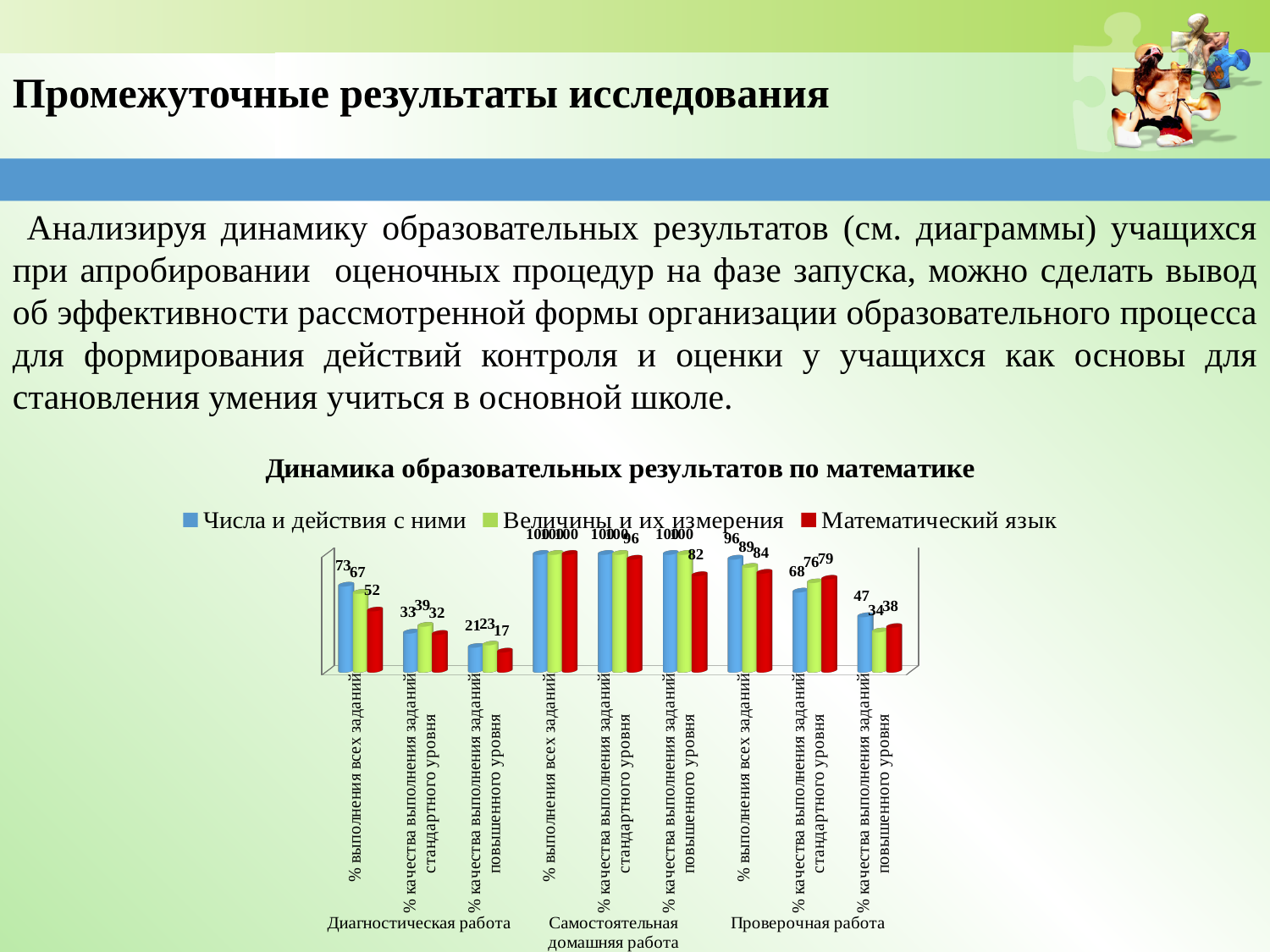
Which series has the lowest value for '% качества выполнения заданий повышенного уровня' in the 'Диагностическая работа' group? Математический язык What is the value of 'Числа и действия с ними' for '% выполнения всех заданий' in the 'Диагностическая работа' group? 73 What is the value of 'Величины и их измерения' for '% качества выполнения заданий стандартного уровня' in the 'Диагностическая работа' group? 39 What is the value of 'Математический язык' for '% выполнения всех заданий' in the 'Диагностическая работа' group? 52 What is the difference between 'Числа и действия с ними' (73) and 'Математический язык' (52) for '% выполнения всех заданий' in the 'Диагностическая работа' group? 21 What is the value of 'Числа и действия с ними' for '% выполнения всех заданий' in the 'Проверочная работа' group? 96 How many series does the legend list in the chart 'Динамика образовательных результатов по математике'? 3 For '% качества выполнения заданий повышенного уровня' in the 'Проверочная работа' group, which is larger: 'Числа и действия с ними' or 'Величины и их измерения'? Числа и действия с ними What is the value of 'Математический язык' for '% качества выполнения заданий повышенного уровня' in the 'Самостоятельная домашняя работа' group? 82 What type of chart is shown on the slide? bar chart What is the title of the chart on the slide? Динамика образовательных результатов по математике Which series has the highest value for '% качества выполнения заданий стандартного уровня' in the 'Проверочная работа' group? Математический язык